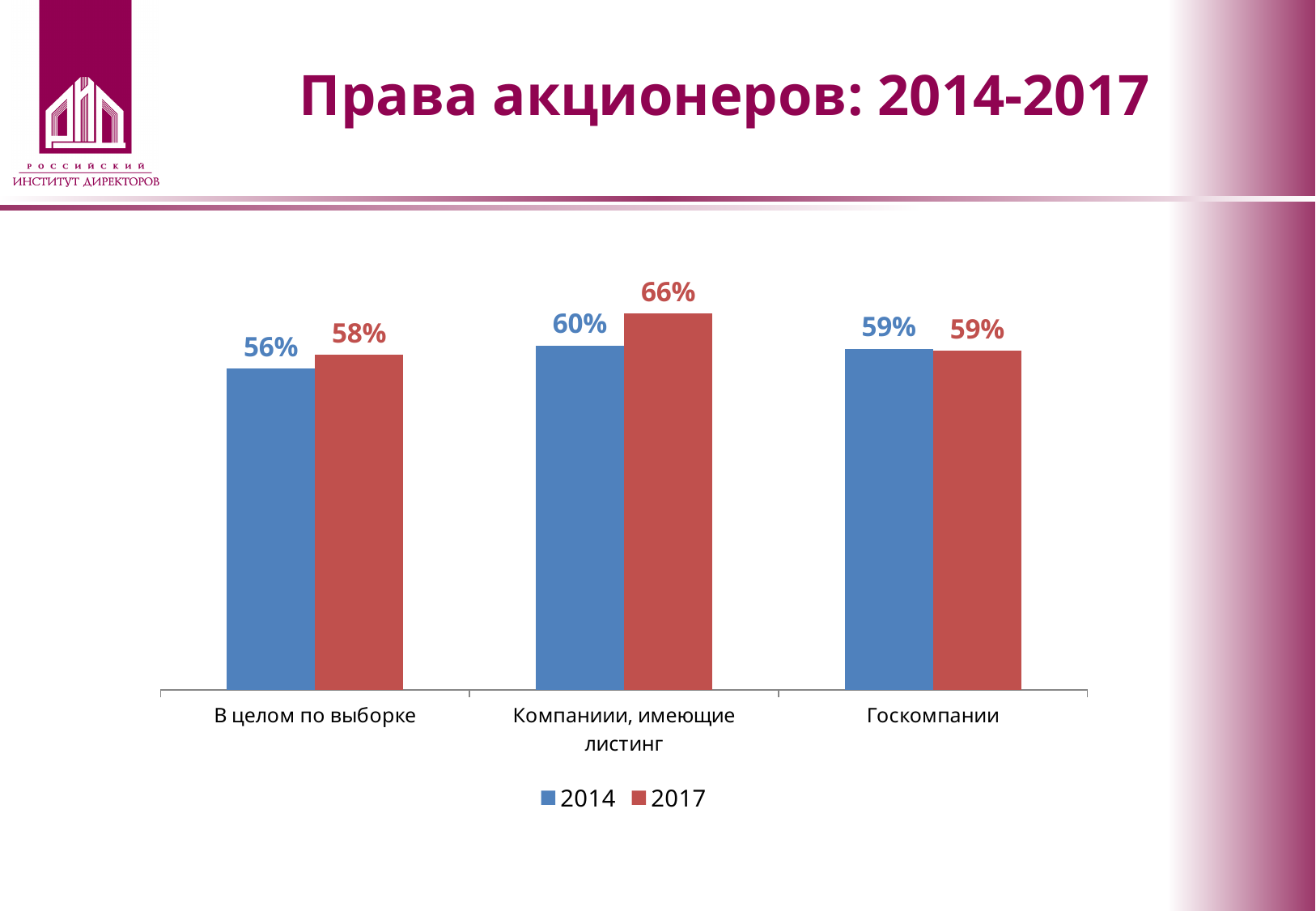
What is the difference between the 2017 and 2014 values for «Компаниии, имеющие листинг»? 6% Which category has the lowest 2014 value? В целом по выборке What kind of chart is shown on the slide? Bar chart What is the 2017 value for «Госкомпании»? 59% What is the 2017 value for «Компаниии, имеющие листинг»? 66% How many categories are shown on the x axis? 3 How many series does the legend list? 2 What is the 2014 value for «В целом по выборке»? 56% What is the difference between the 2017 and 2014 values for «В целом по выборке»? 2% Which is larger for «Госкомпании»: the 2014 value or the 2017 value? They are equal (59%) Which category has the highest 2017 value? Компаниии, имеющие листинг What is the 2014 value for «Компаниии, имеющие листинг»? 60%